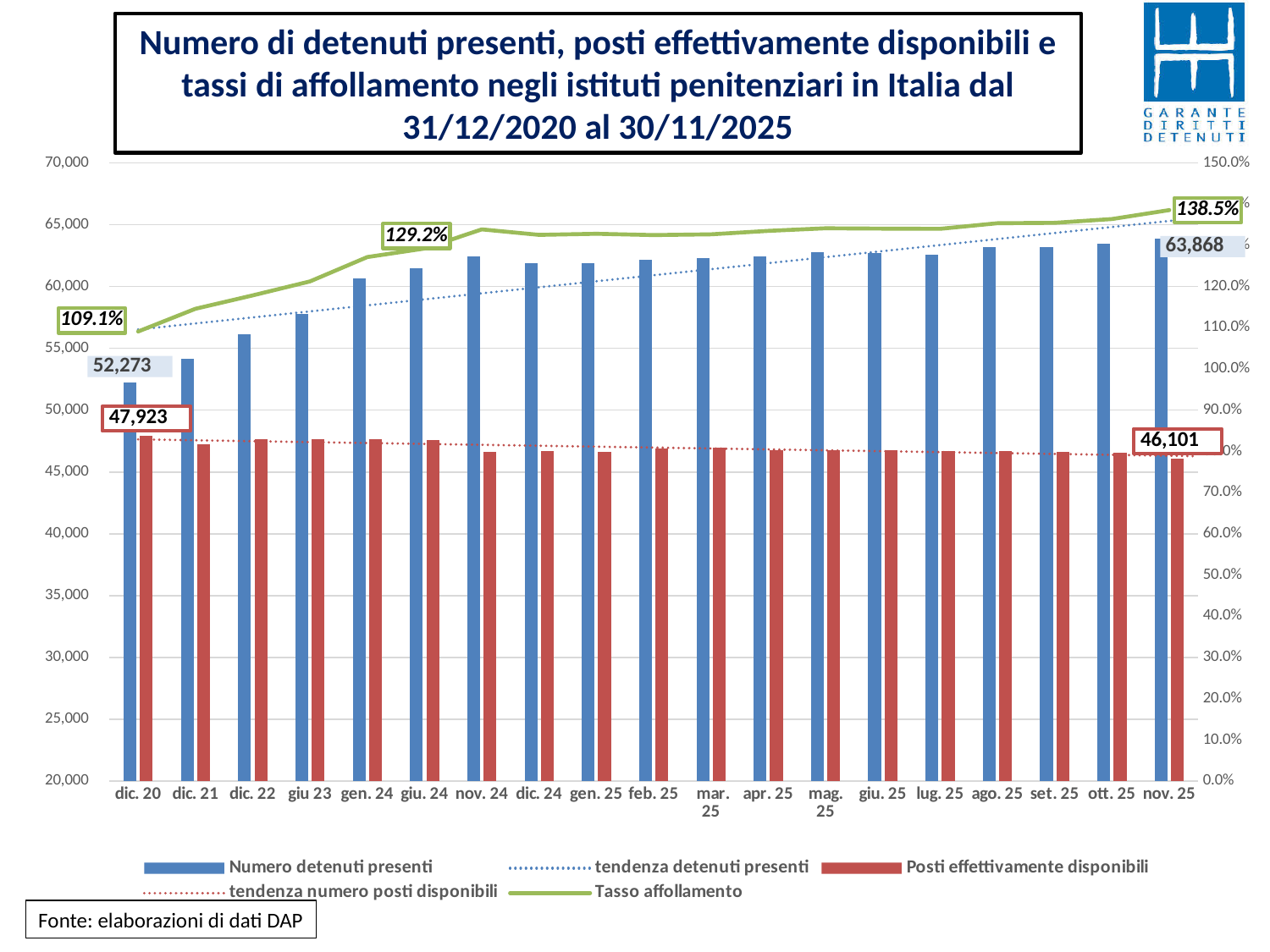
What is the value of Numero detenuti presenti for nov. 25? 63,868 By how much did Numero detenuti presenti increase from dic. 20 to nov. 25? 11,595 What is the Tasso affollamento for nov. 25? 138.5% What is the value of Numero detenuti presenti for dic. 20? 52,273 What is the value of Posti effettivamente disponibili for dic. 20? 47,923 How many time periods are shown on the x axis? 19 What type of chart is shown on the slide? Combined bar and line chart Which period has the highest Numero detenuti presenti? nov. 25 What is the value of Posti effettivamente disponibili for nov. 25? 46,101 Does Numero detenuti presenti generally rise or fall from dic. 20 to nov. 25? Rise What is the difference between Numero detenuti presenti and Posti effettivamente disponibili in nov. 25? 17,767 How many series does the legend list? 5